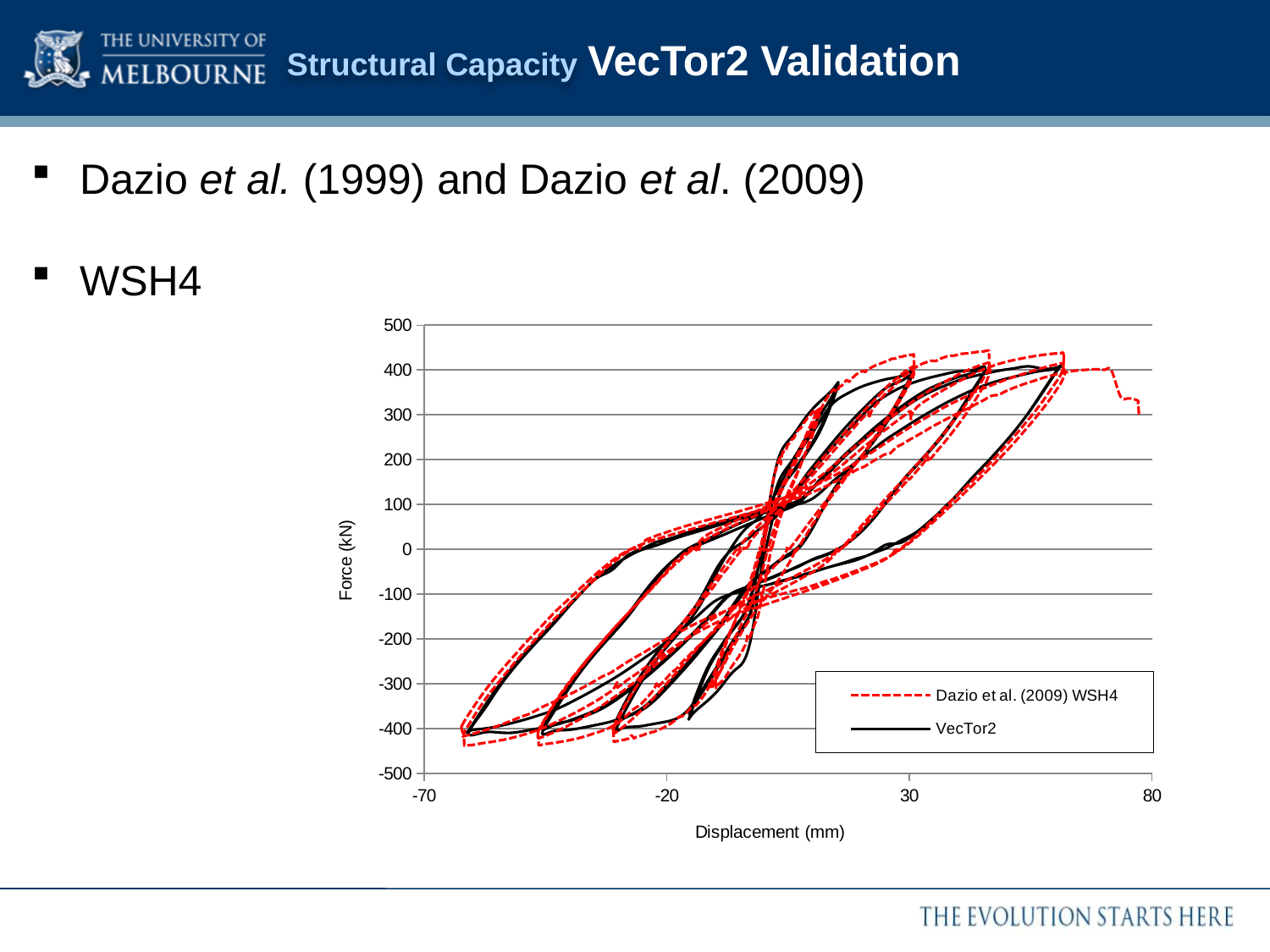
Is the largest positive displacement reached by the Dazio et al. (2009) WSH4 series greater or less than 30 mm? greater Is the peak force reached by either series greater or less than 500 kN? less What are the two series named in the chart legend? Dazio et al. (2009) WSH4 and VecTor2 How many series does the chart legend list? 2 What is the highest value shown on the vertical axis of the chart? 500 What is the lowest value shown on the horizontal axis of the chart? -70 What kind of chart is shown on the slide? line chart Which series is drawn as a red dashed line? Dazio et al. (2009) WSH4 Is the peak force reached by the Dazio et al. (2009) WSH4 series greater or less than 400 kN? greater What is the label of the horizontal axis of the chart? Displacement (mm) What is the label of the vertical axis of the chart? Force (kN)